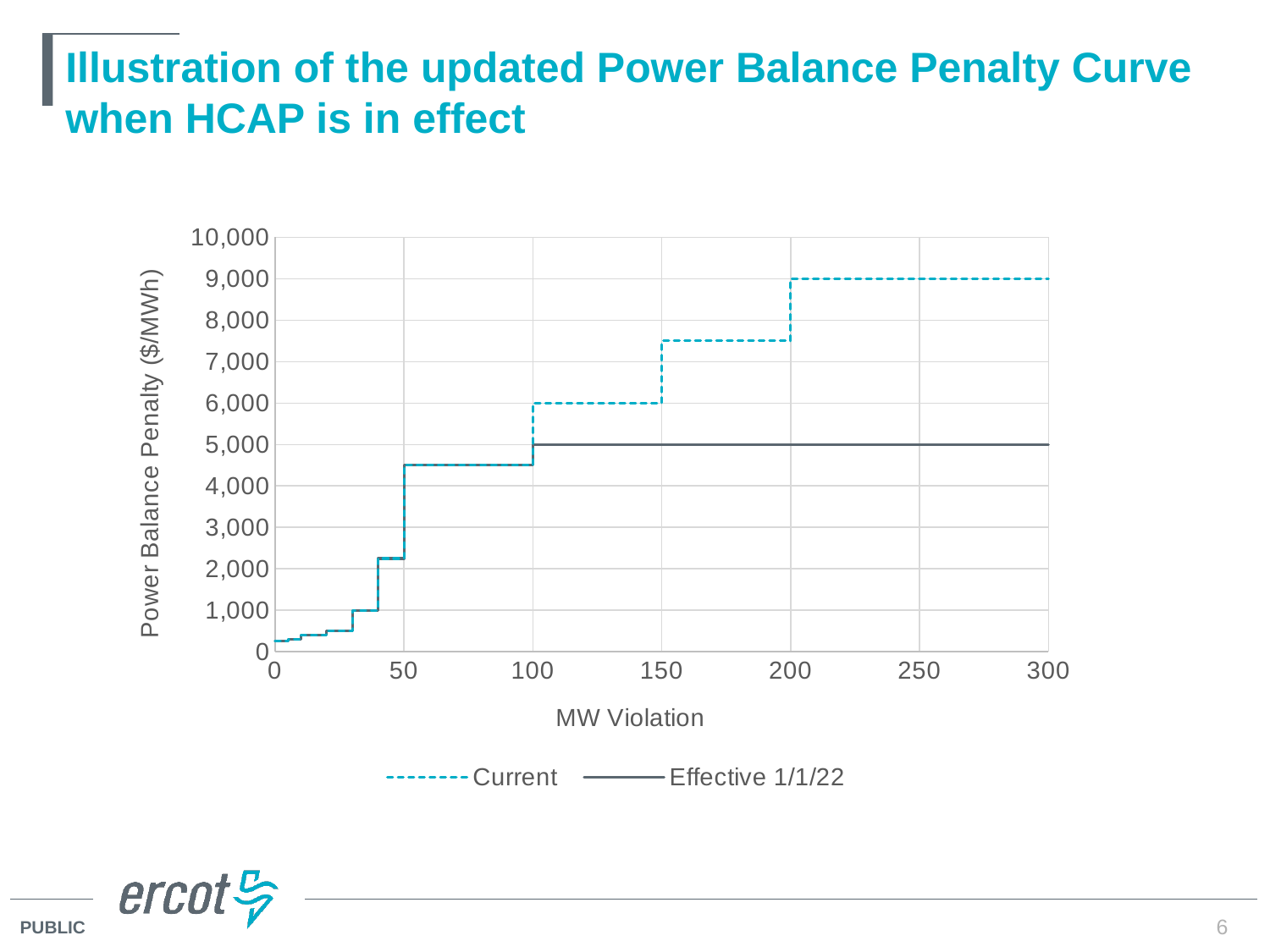
How many series does the legend list? 2 At 250 MW Violation, which series has the higher penalty, Current or Effective 1/1/22? Current What is the value of the Effective 1/1/22 series at 200 MW Violation? 5,000 What are the two series named in the legend? Current and Effective 1/1/22 What is the title of the y axis? Power Balance Penalty ($/MWh) Is the value of the Current series at 175 MW Violation greater or less than 7,000? greater What is the value of the Current series at 125 MW Violation? 6,000 Is the value of the Current series at 75 MW Violation greater or less than 4,000? greater At 250 MW Violation, what is the difference between the Current penalty and the Effective 1/1/22 penalty? 4,000 What kind of chart is shown on the slide? line chart Does the Current series rise or fall as MW Violation increases? rise What is the value of the Current series at 250 MW Violation? 9,000